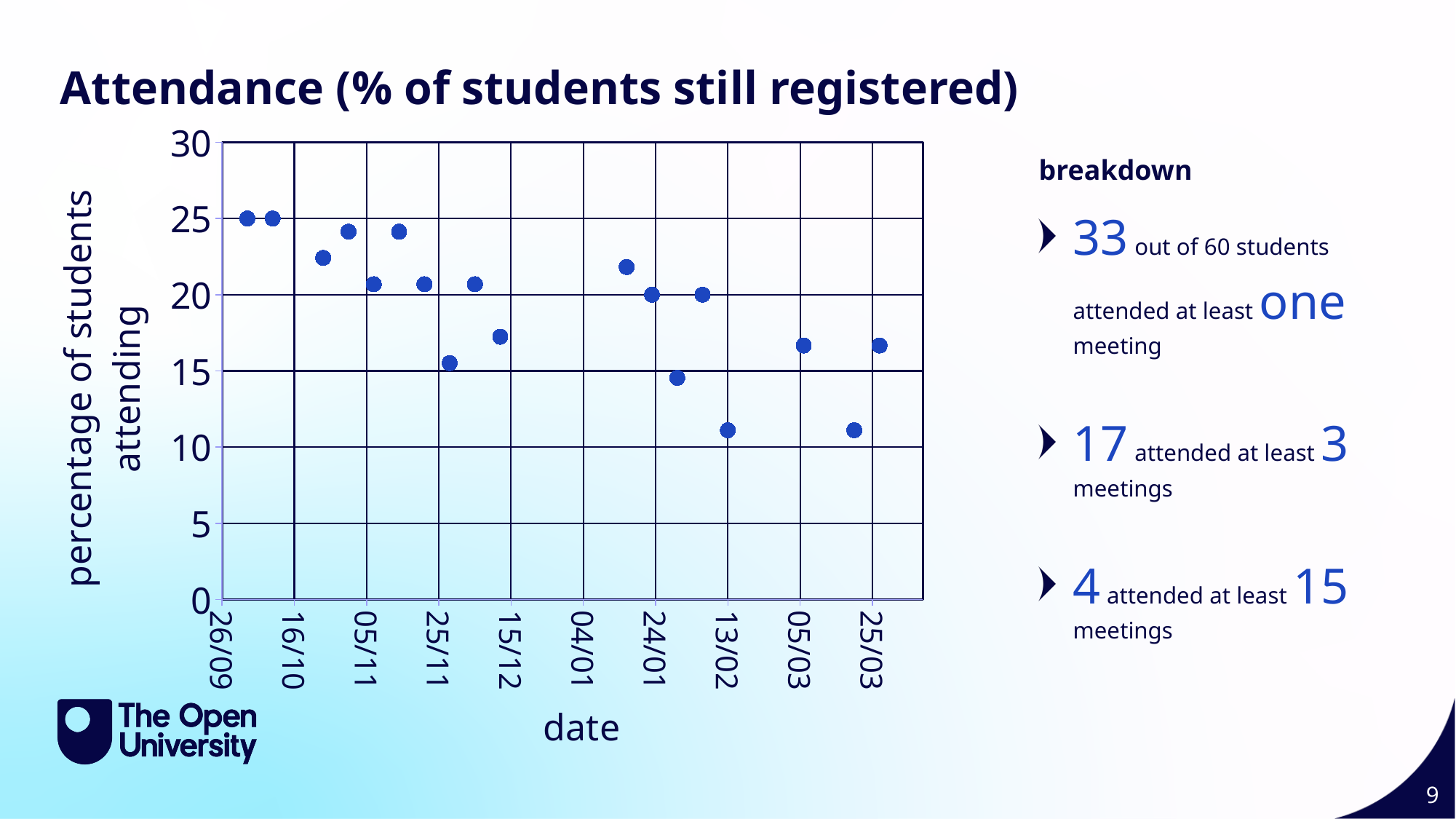
What is the label of the y axis? percentage of students attending Overall, do the plotted attendance percentages rise or fall from 26/09 to 25/03? fall What kind of chart is shown on the slide? scatter chart Is the value of the point plotted at 13/02 greater or less than 15? less What is the maximum value shown on the y axis? 30 Is the lowest plotted attendance percentage greater or less than 15? less Which is larger: the first plotted point (early October) or the last plotted point (late March)? the first plotted point What is the highest percentage value reached by any point on the chart? 25 How many data points are plotted on the chart? 18 Which is larger: the point plotted at 13/02 or the point plotted at 05/03? the point at 05/03 What is the title of the chart? Attendance (% of students still registered) Is the value of the first plotted point (just after 26/09) greater or less than 20? greater